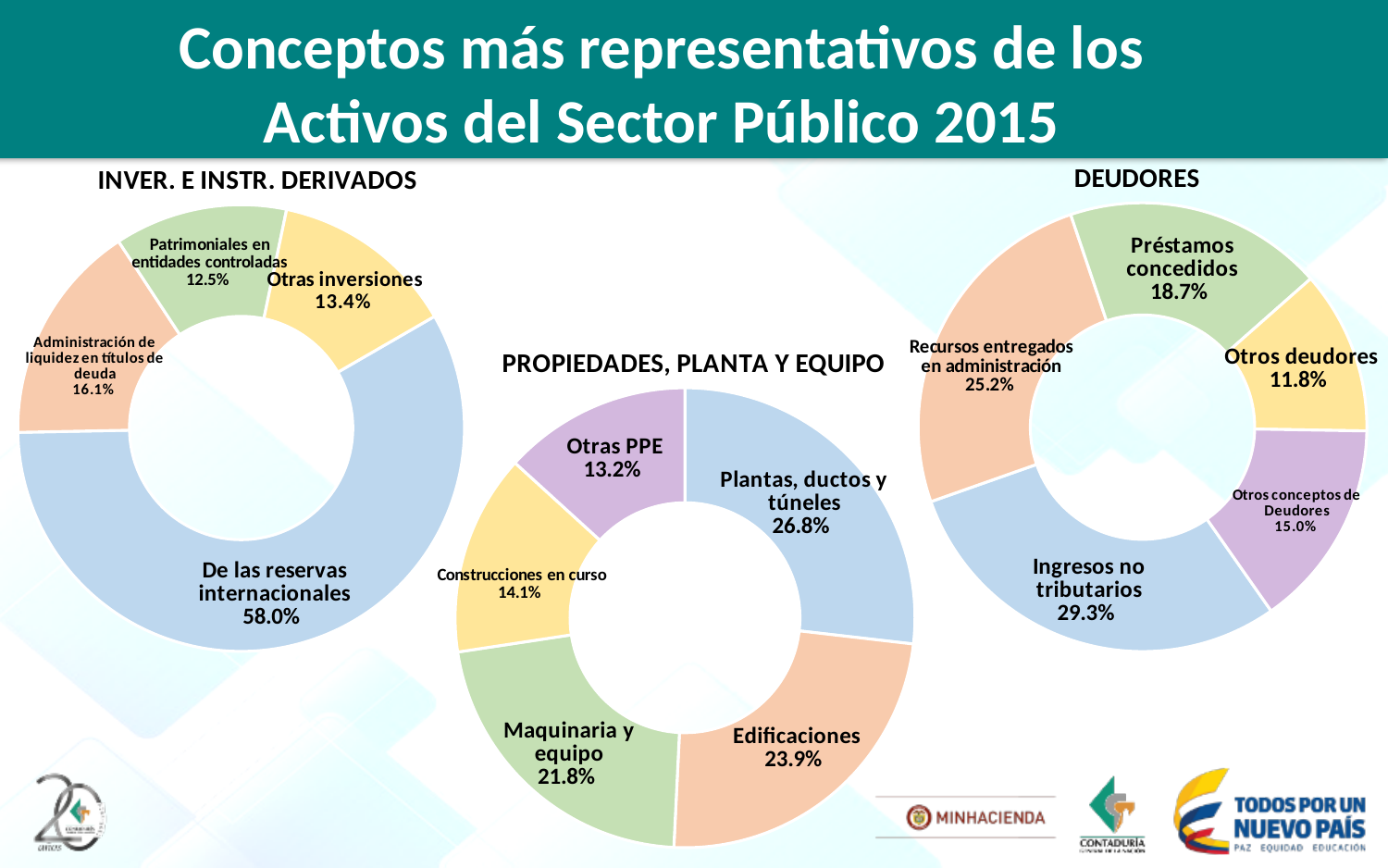
In the DEUDORES chart, which category has the largest share? Ingresos no tributarios In the DEUDORES chart, how many categories are shown? 5 In the DEUDORES chart, which category has the smallest share? Otros deudores In the PROPIEDADES, PLANTA Y EQUIPO chart, what is the difference in percentage points between 'Plantas, ductos y túneles' and 'Otras PPE'? 13.6 In the PROPIEDADES, PLANTA Y EQUIPO chart, what share is 'Edificaciones'? 23.9% In the INVER. E INSTR. DERIVADOS chart, which category has the smallest share? Patrimoniales en entidades controladas In the INVER. E INSTR. DERIVADOS chart, what share is 'De las reservas internacionales'? 58.0% In the INVER. E INSTR. DERIVADOS chart, how many slices are there? 4 In the DEUDORES chart, what share is 'Recursos entregados en administración'? 25.2% What type of chart is used for the three charts on the slide? Pie (donut) chart In the PROPIEDADES, PLANTA Y EQUIPO chart, which is larger: 'Maquinaria y equipo' or 'Construcciones en curso'? Maquinaria y equipo In the PROPIEDADES, PLANTA Y EQUIPO chart, which category has the largest share? Plantas, ductos y túneles